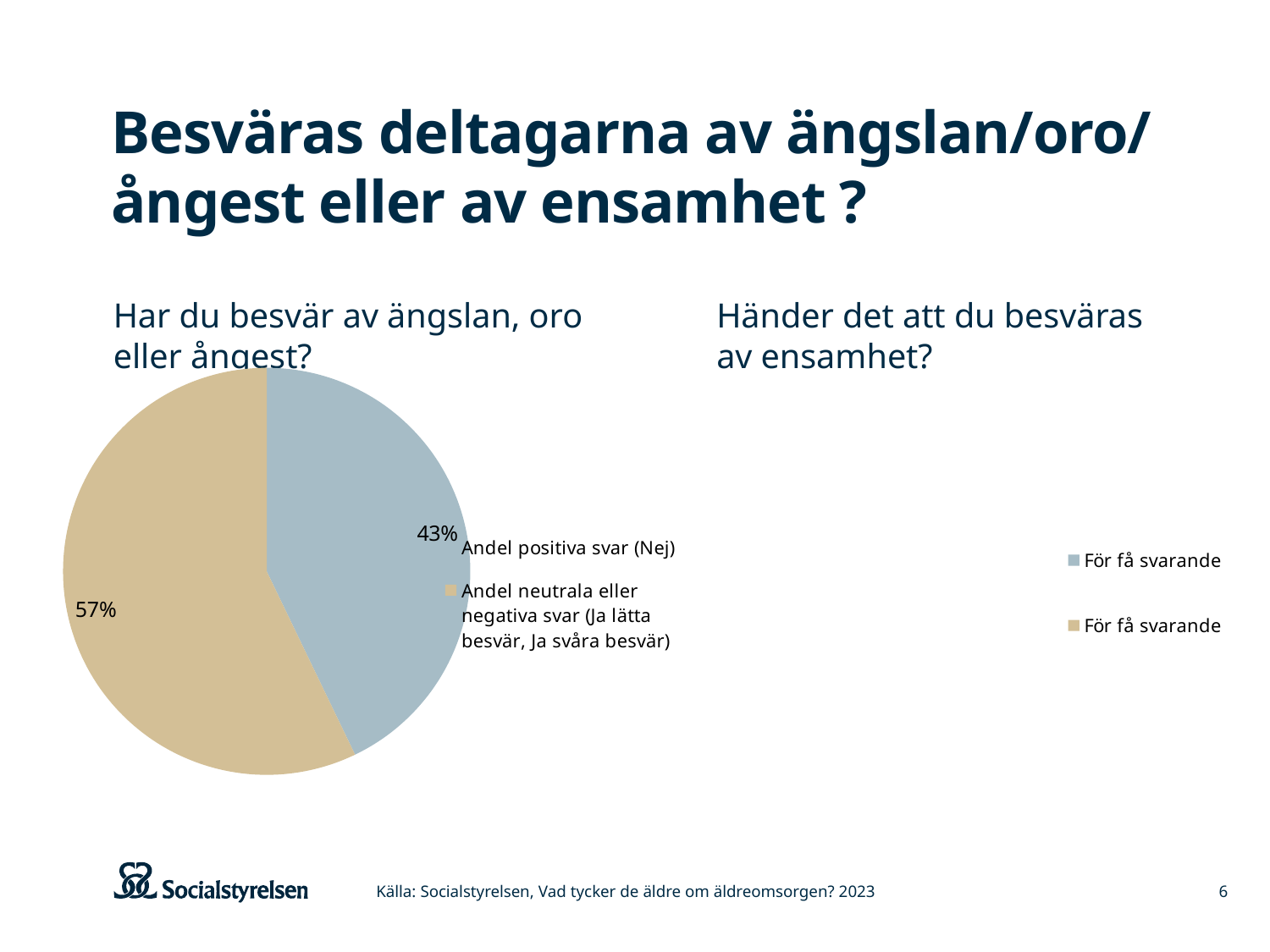
In the chart titled "Har du besvär av ängslan, oro eller ångest?", which slice is the largest? Andel neutrala eller negativa svar (Ja lätta besvär, Ja svåra besvär) What does the legend of the chart on the right, titled "Händer det att du besväras av ensamhet?", say for both entries? För få svarande How many slices does the pie chart titled "Har du besvär av ängslan, oro eller ångest?" have? 2 What kind of chart is the one titled "Har du besvär av ängslan, oro eller ångest?"? Pie chart How many entries does the legend of the chart titled "Har du besvär av ängslan, oro eller ångest?" list? 2 In the chart titled "Har du besvär av ängslan, oro eller ångest?", what share is labelled for "Andel positiva svar (Nej)"? 43% In the chart titled "Har du besvär av ängslan, oro eller ångest?", what colour is the slice for "Andel positiva svar (Nej)"? Blue-grey In the chart titled "Har du besvär av ängslan, oro eller ångest?", what is the difference in percentage points between the two slices? 14 percentage points In the chart titled "Har du besvär av ängslan, oro eller ångest?", what share is labelled for "Andel neutrala eller negativa svar (Ja lätta besvär, Ja svåra besvär)"? 57% In the chart titled "Har du besvär av ängslan, oro eller ångest?", which is larger: the share of positive answers (Nej) or the share of neutral or negative answers? Andel neutrala eller negativa svar In the chart titled "Har du besvär av ängslan, oro eller ångest?", which slice is the smallest? Andel positiva svar (Nej)